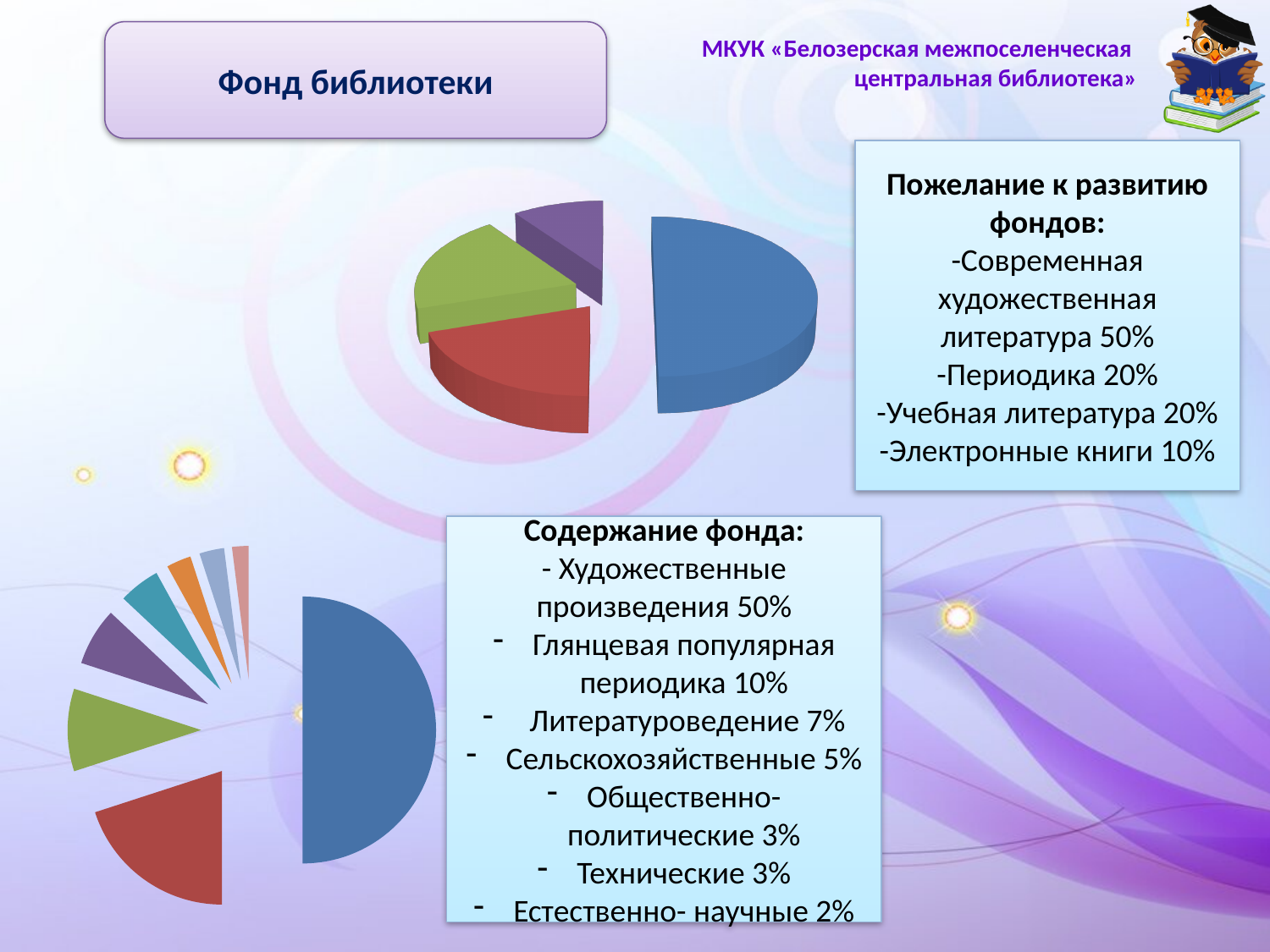
In the lower-left pie chart, which is larger, the red slice or the green slice? red How many slices does the lower-left pie chart have? 8 What kind of chart is the chart in the upper middle of the slide? pie chart In the upper pie chart, which is larger, the green slice or the purple slice? green What kind of chart is the chart in the lower left of the slide? pie chart In the upper pie chart, which is larger, the blue slice or the red slice? blue How many pie charts are shown on the slide? 2 How many slices does the upper pie chart have? 4 In the upper pie chart, which colour slice is the largest? blue In the lower-left pie chart, which colour slice is the largest? blue In the upper pie chart, which colour slice is the smallest? purple